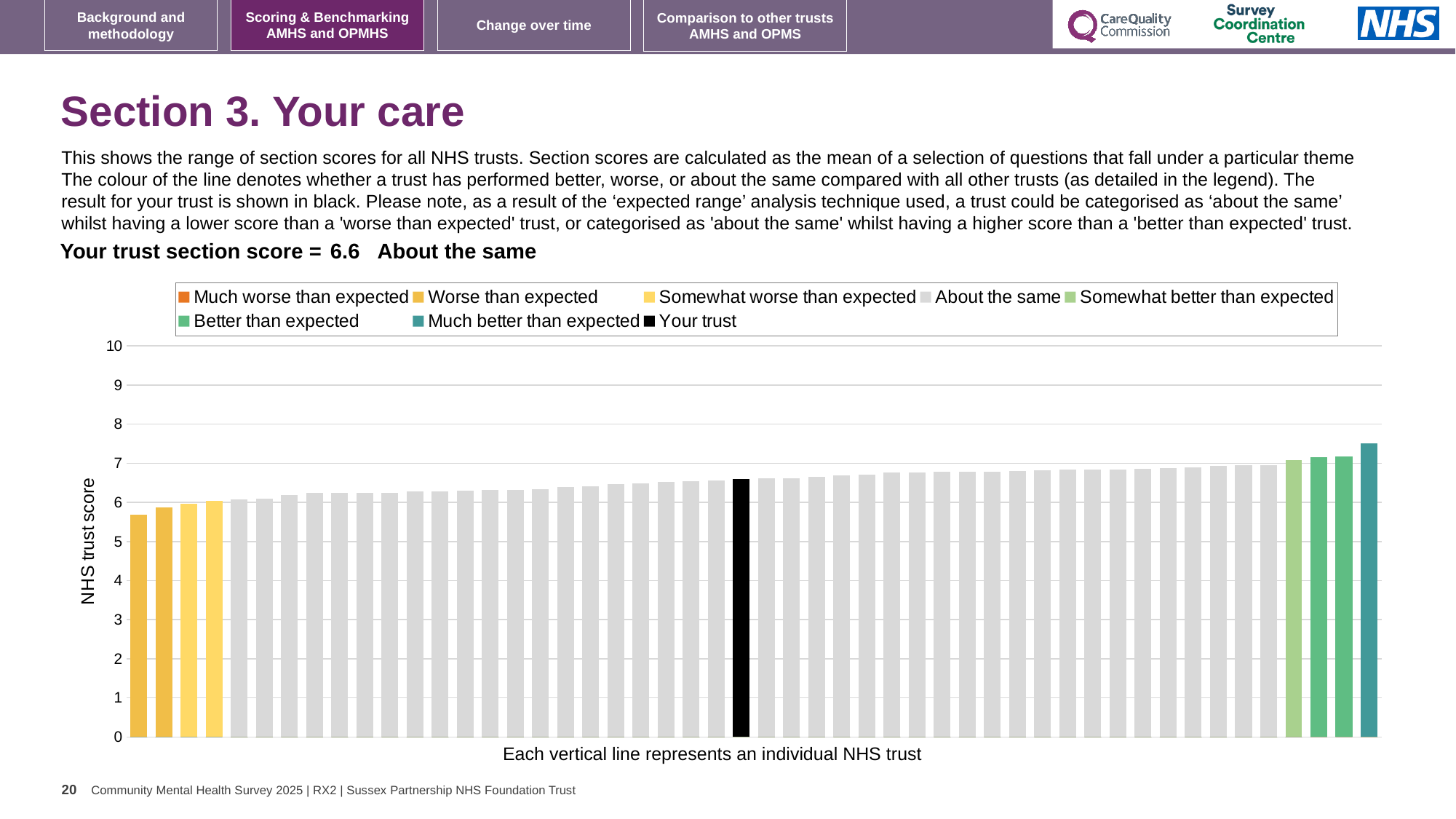
What kind of chart is shown on the slide? bar chart Is the value of the shortest bar greater or less than 6? less Do the bar values rise or fall from left to right along the x axis? rise What is the label on the vertical axis of the chart? NHS trust score Is the value of the tallest bar greater or less than 7? greater How many entries does the chart legend list? 8 What is the section score for your trust shown on the slide? 6.6 Is the value of the tallest bar greater or less than 8? less Which category is your trust's section score placed in? About the same Which legend category is shown in black? Your trust